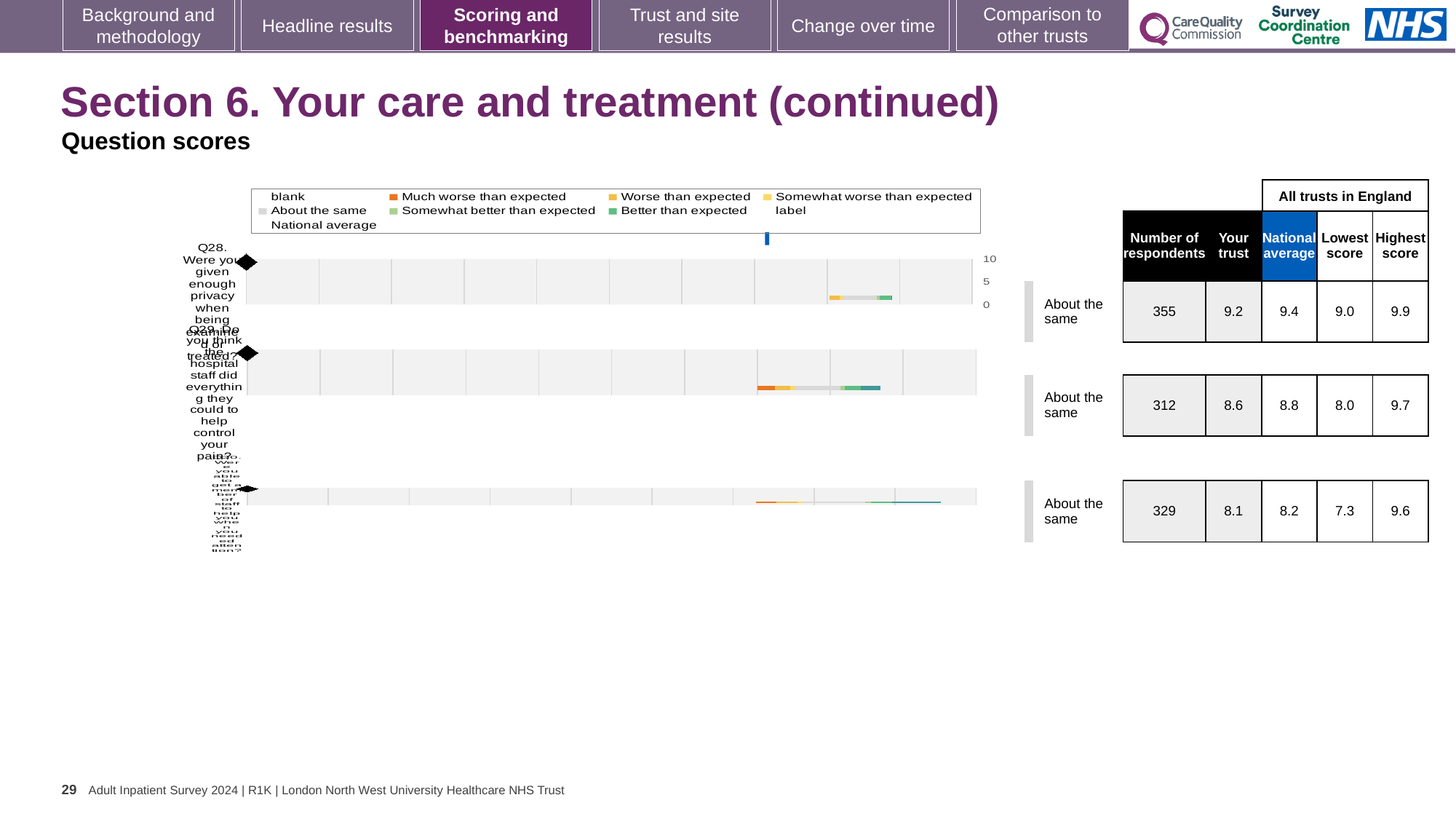
What benchmark category is shown for Q29? About the same How many respondents answered Q30 (Were you able to get a member of staff to help you when you needed attention?)? 329 Which of the three questions shown has the highest 'Your trust' score? Q28 How many questions are plotted on this slide? 3 Which of the three questions shown has the lowest 'Your trust' score? Q30 For Q28, which is larger: the 'Your trust' score or the national average? National average What is the national average score for Q29 (Do you think the hospital staff did everything they could to help control your pain?)? 8.8 Is the 'Your trust' score for Q30 greater or less than 5 on the chart axis? greater What is the 'Your trust' score for Q28 (Were you given enough privacy when being examined or treated?)? 9.2 What is the difference between the highest score (9.9) and the lowest score (9.0) for Q28? 0.9 What is the difference between the 'Your trust' scores for Q28 and Q29? 0.6 What is the lowest score among all trusts in England for Q30? 7.3